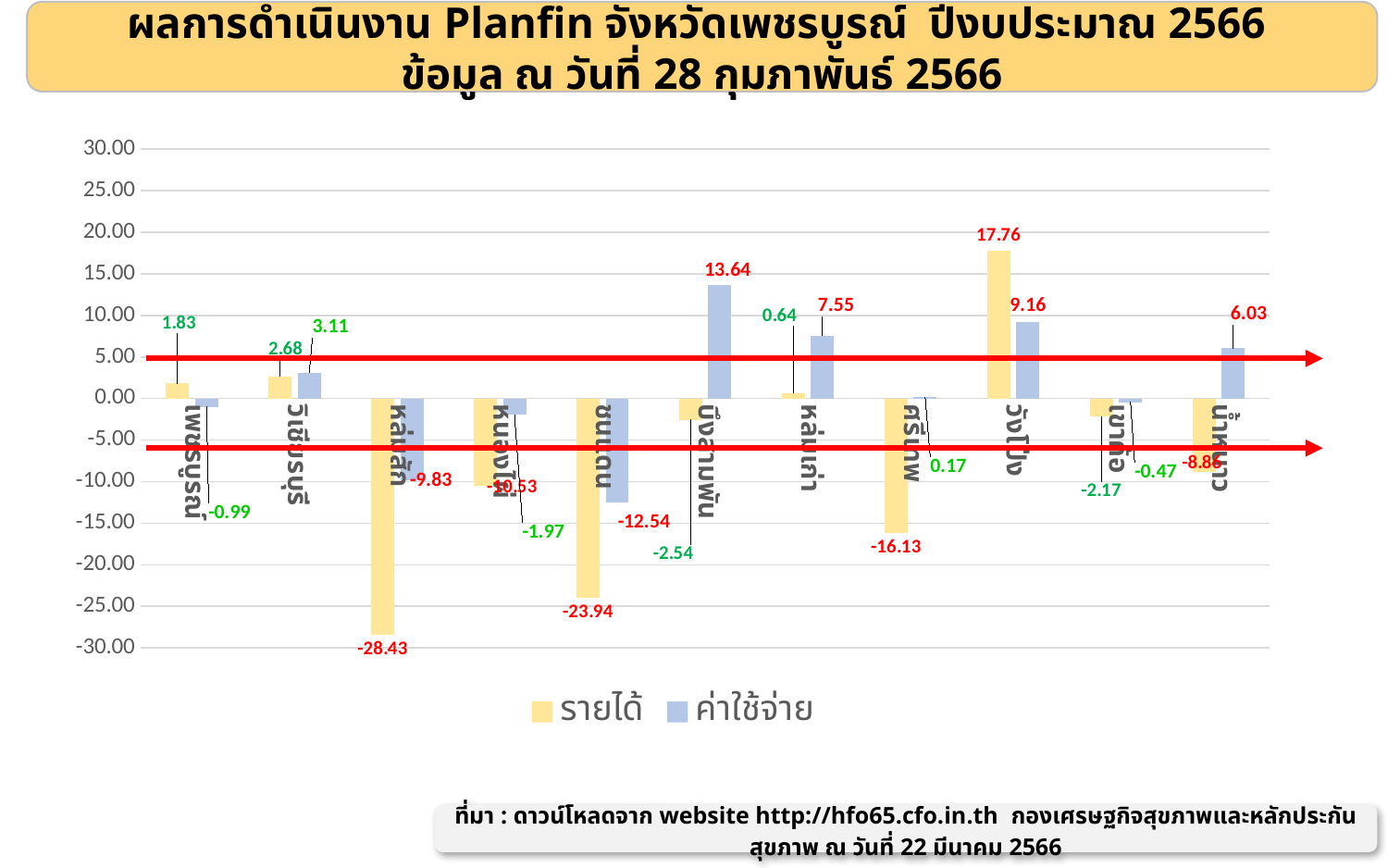
What is the ค่าใช้จ่าย value for บึงสามพัน? 13.64 What is the รายได้ value for หล่มสัก? -28.43 Which is larger for หล่มเก่า, the รายได้ value or the ค่าใช้จ่าย value? ค่าใช้จ่าย What is the difference between the รายได้ and ค่าใช้จ่าย values for วังโป่ง? 8.60 Which category has the highest ค่าใช้จ่าย value? บึงสามพัน What is the ค่าใช้จ่าย value for ชนแดน? -12.54 How many series does the legend list? 2 How many categories (districts) are shown on the x axis? 11 What is the รายได้ value for วังโป่ง? 17.76 Which series is shown in yellow in the legend? รายได้ What type of chart is shown on the slide? bar chart Which category has the lowest รายได้ value? หล่มสัก